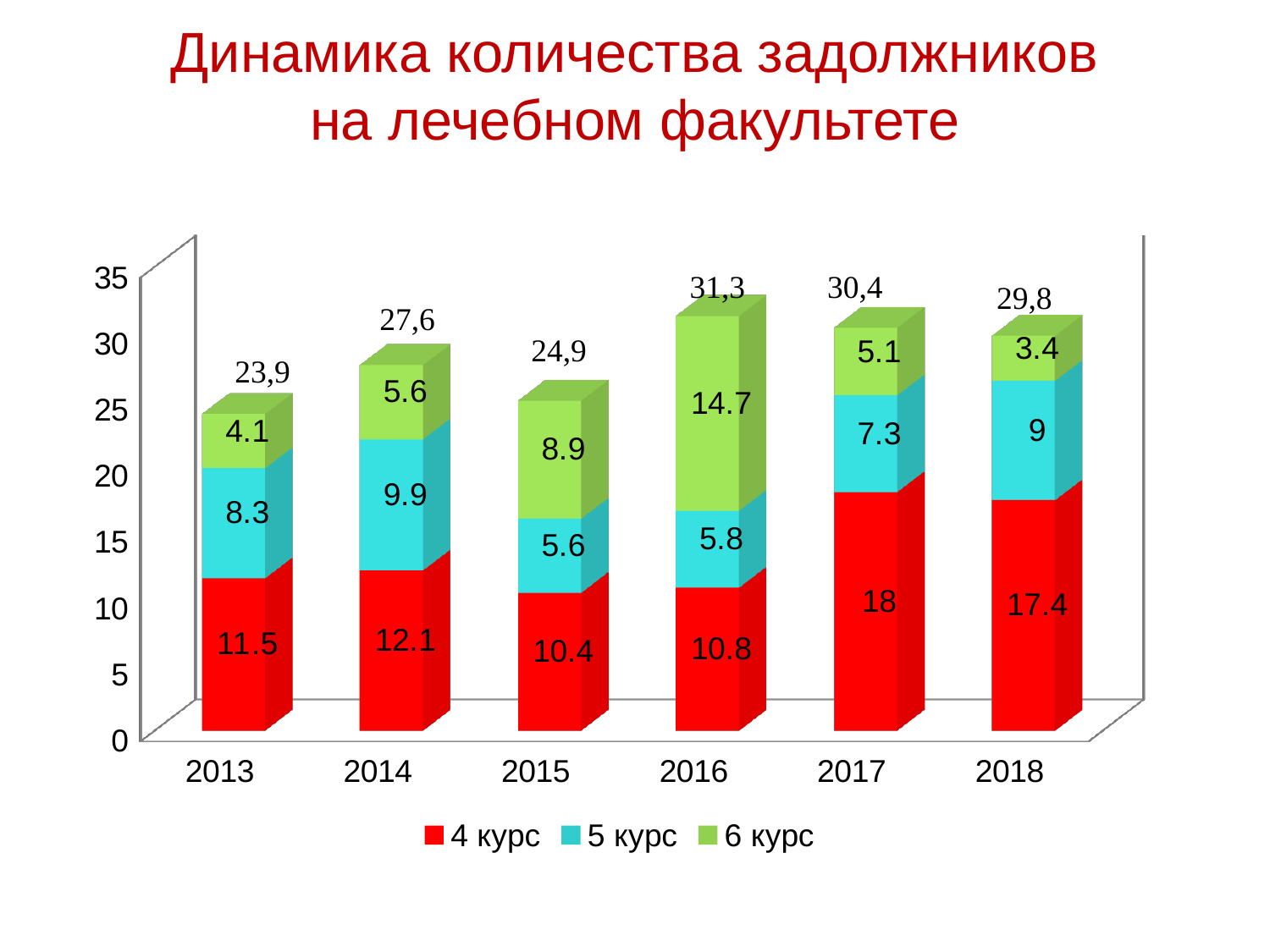
Which is larger: the 5 курс value for 2013 or for 2018? 2018 What kind of chart is shown on the slide? Stacked bar chart What is the difference between the 4 курс values for 2017 and 2018? 0.6 How many years are shown on the x axis? 6 How many series does the legend list? 3 What is the total of the stacked bar for 2014? 27,6 Which year has the highest total number of задолжники? 2016 In which year is the value for 6 курс the lowest? 2018 What is the value for 5 курс in 2014? 9.9 Do the total values rise or fall from 2016 to 2018? Fall What is the value for 4 курс in 2017? 18 What is the value for 6 курс in 2016? 14.7